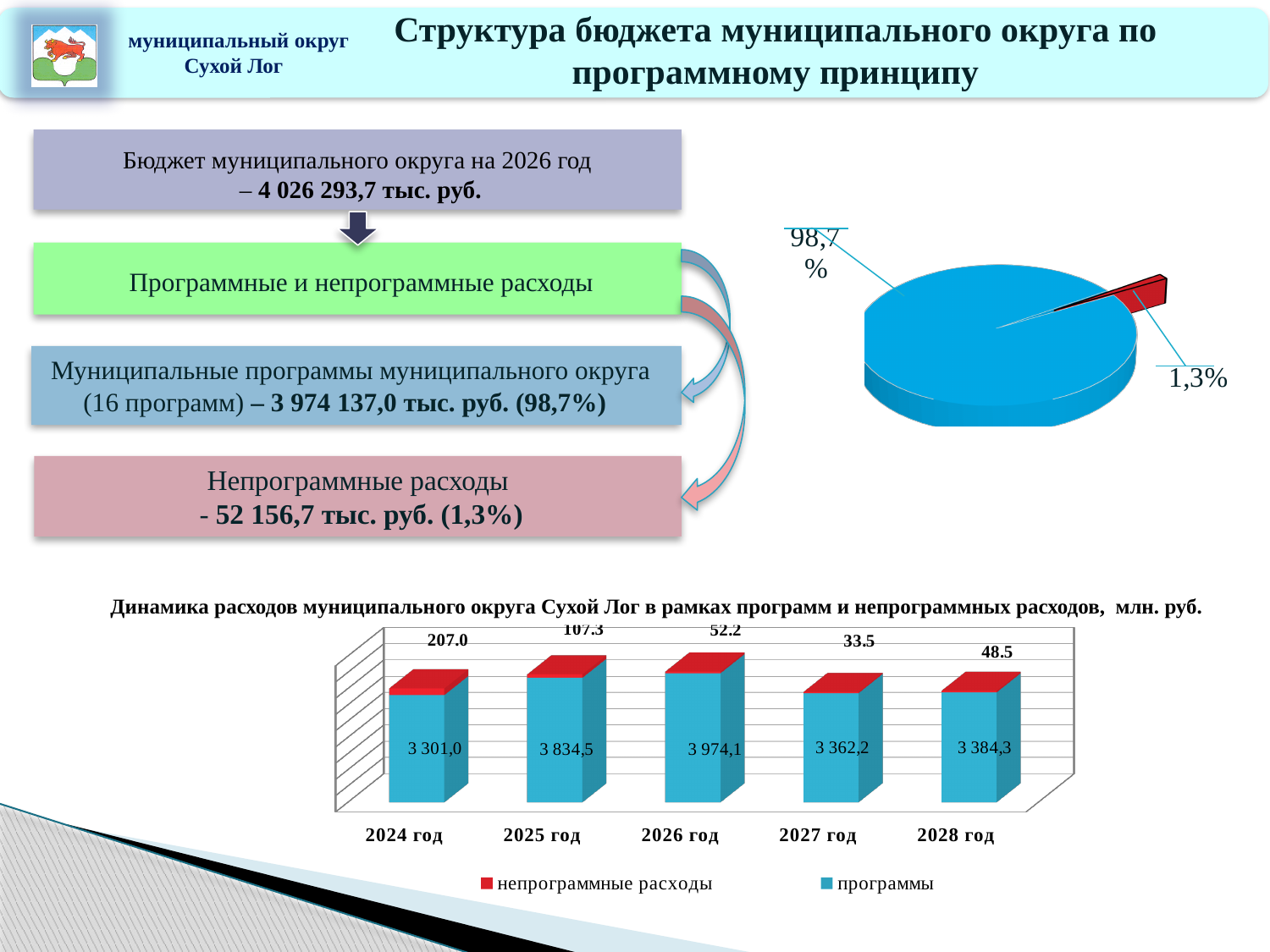
In the bar chart at the bottom, what is the value of 'непрограммные расходы' for 2024 год? 207.0 In the bar chart at the bottom, what is the value of 'программы' for 2026 год? 3 974,1 In the pie chart, what share does the small red slice represent? 1,3% In the bar chart at the bottom, do the values for 'непрограммные расходы' rise or fall from 2024 год to 2027 год? fall What kind of chart is the chart at the bottom of the slide titled 'Динамика расходов муниципального округа Сухой Лог...'? bar chart In the bar chart at the bottom, which year has the highest value for 'программы'? 2026 год In the pie chart, what share does the large blue slice represent? 98,7% How many slices does the pie chart have? 2 How many series does the legend of the bar chart at the bottom list? 2 In the bar chart at the bottom, which year has the lowest value for 'программы'? 2024 год How many years are shown on the x axis of the bar chart at the bottom? 5 In the bar chart at the bottom, which year has the larger value for 'непрограммные расходы': 2027 год or 2028 год? 2028 год